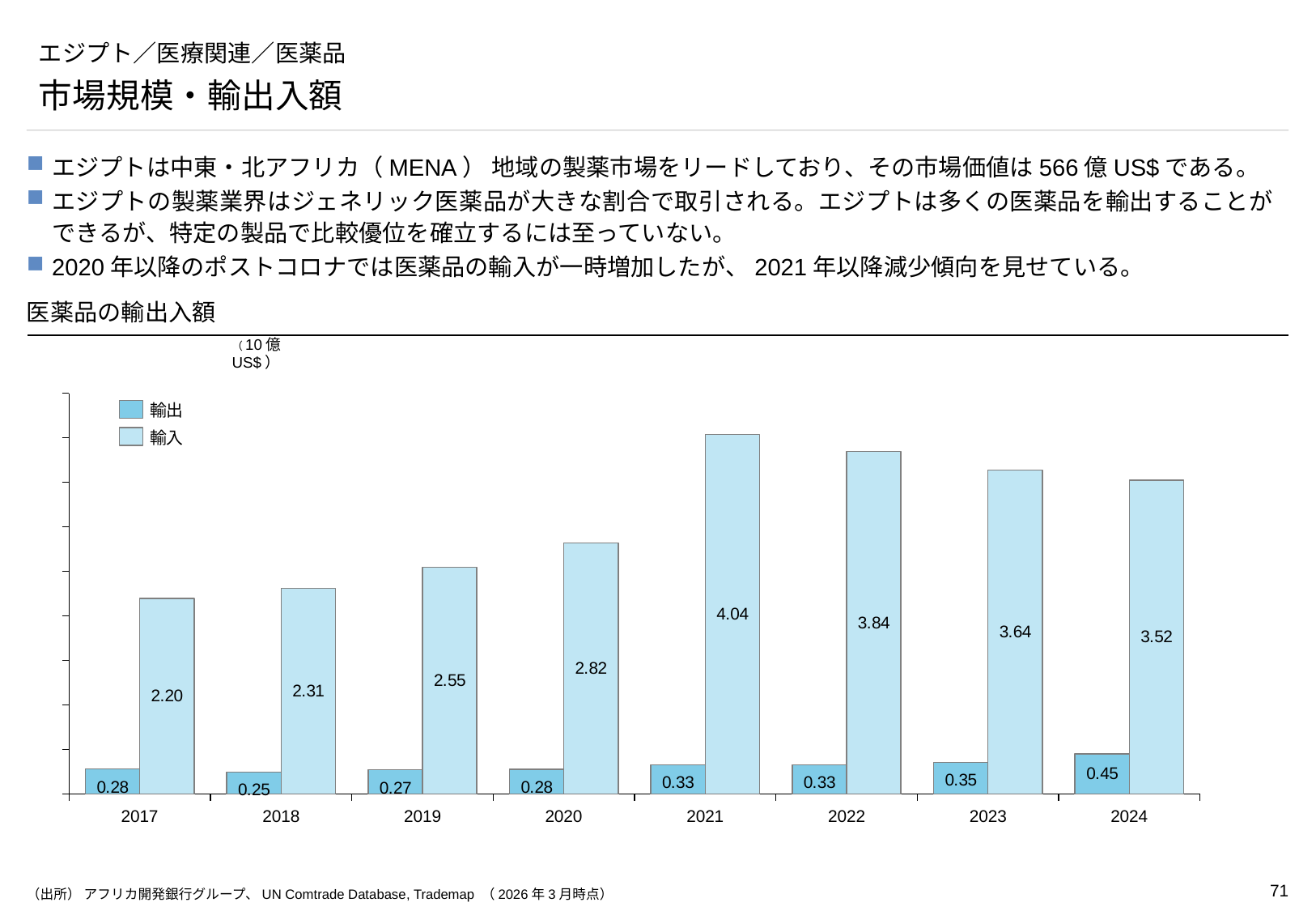
What is the difference between 輸入 (imports) in 2021 and 2024? 0.52 Which is larger, 輸入 (imports) in 2019 or in 2020? 2020 How many series does the legend list? 2 What unit is shown for the chart values? 10億US$ In which year is 輸出 (exports) lowest? 2018 What is the value of 輸入 (imports) in 2017? 2.20 Does 輸入 (imports) rise or fall from 2021 to 2024? fall How many years are shown on the x axis? 8 What is the value of 輸出 (exports) in 2024? 0.45 What type of chart is shown on the slide? bar chart In which year is 輸入 (imports) highest? 2021 What is the value of 輸入 (imports) in 2021? 4.04